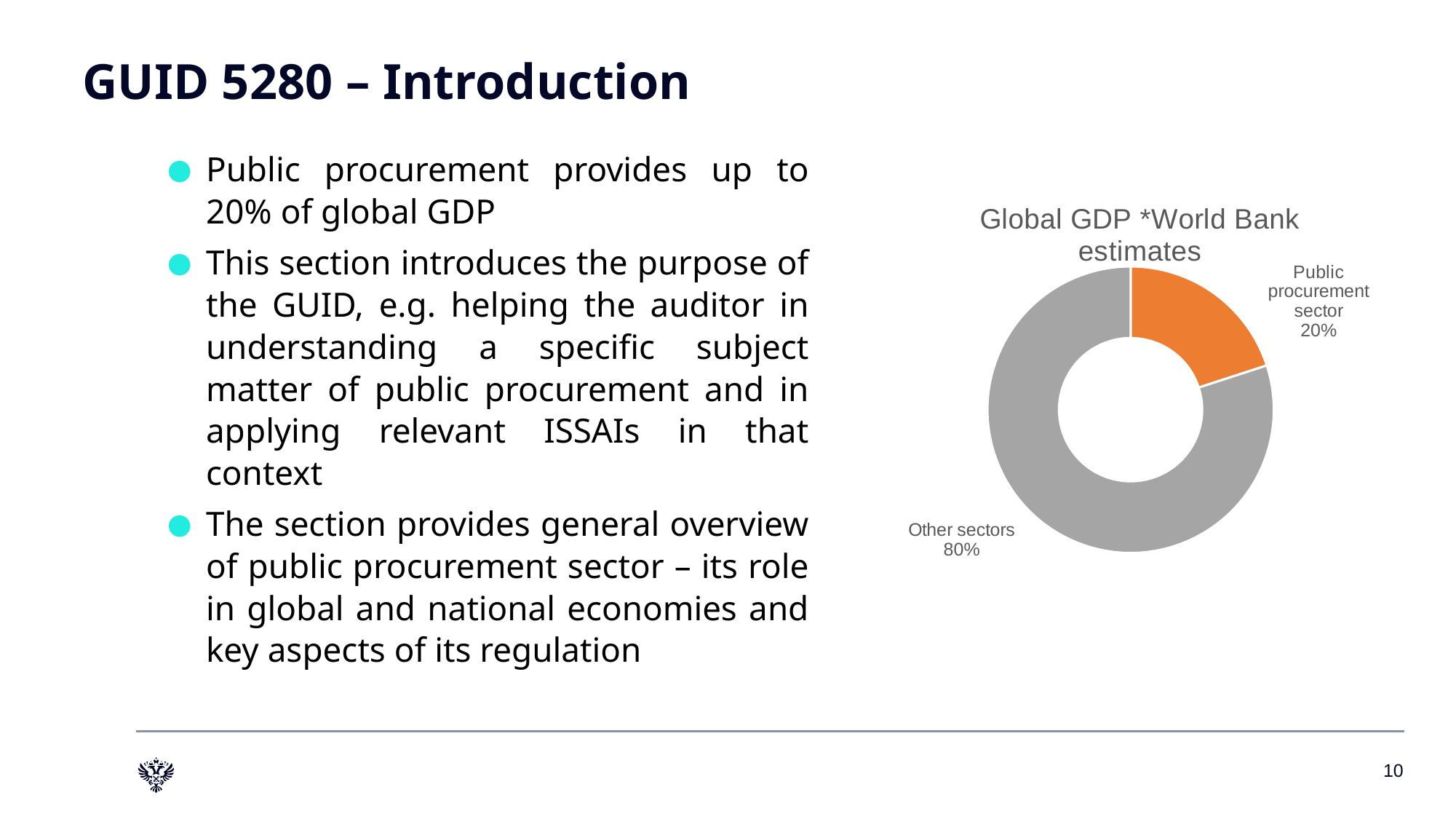
What share of global GDP does the Other sectors slice represent in the chart? 80% What colour is the Public procurement sector slice? Orange What kind of chart is shown on the slide? Doughnut (pie) chart What is the title of the chart? Global GDP *World Bank estimates Which slice of the chart is the largest? Other sectors What is the difference in percentage points between the Other sectors slice and the Public procurement sector slice? 60 Which is larger, the Public procurement sector slice or the Other sectors slice? Other sectors Which slice of the chart is the smallest? Public procurement sector What share of global GDP does the Public procurement sector slice represent in the chart? 20% How many slices does the chart have? 2 What is the total of the two slices shown in the chart? 100%